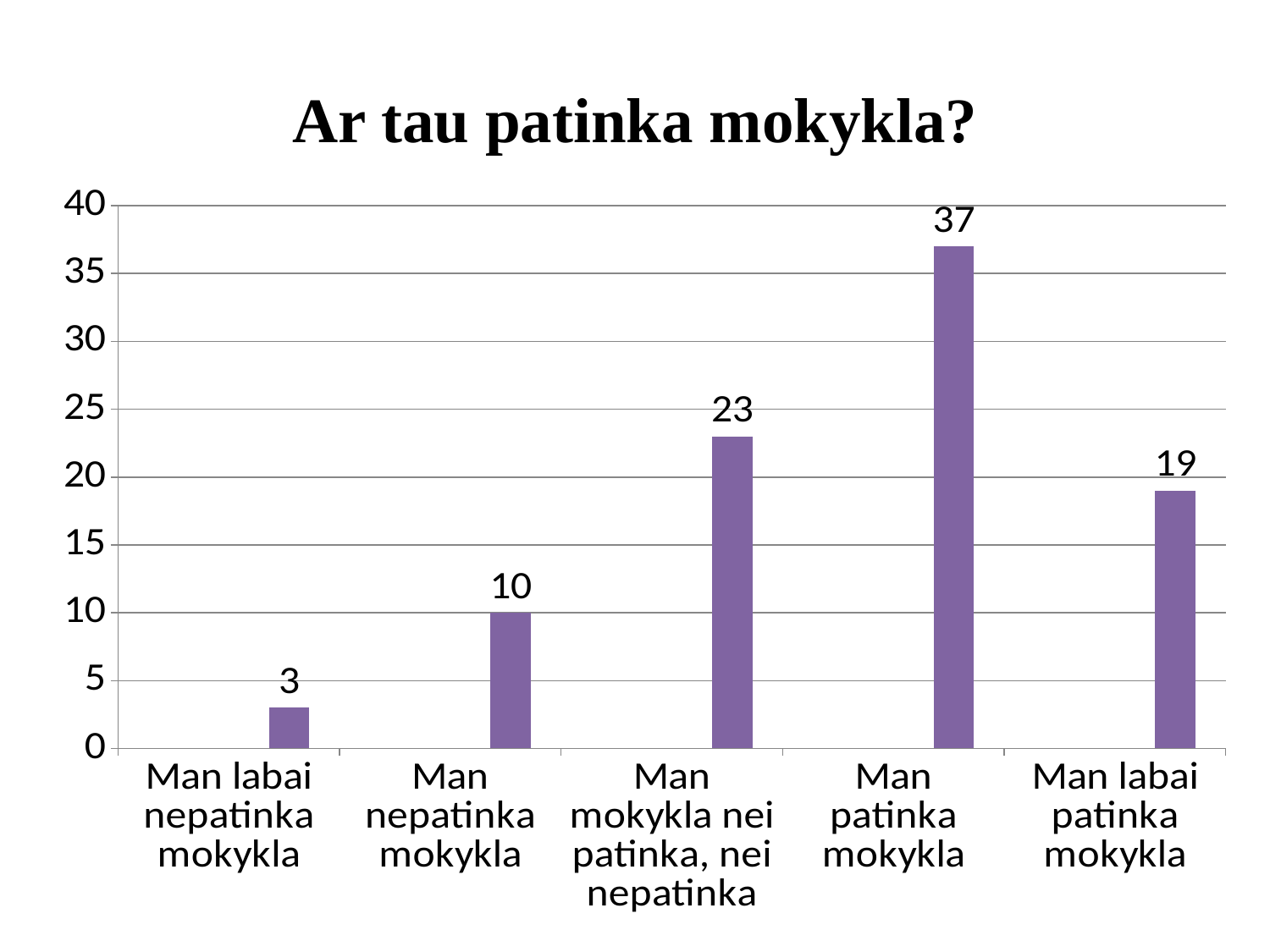
Which category has the lowest value? Man labai nepatinka mokykla Which category has the highest value? Man patinka mokykla Is the value for "Man mokykla nei patinka, nei nepatinka" greater or less than 20? greater What is the value for "Man labai nepatinka mokykla"? 3 What is the difference between the values for "Man patinka mokykla" and "Man labai patinka mokykla"? 18 What kind of chart is shown on the slide? bar chart What is the value for "Man mokykla nei patinka, nei nepatinka"? 23 How many categories are shown on the chart? 5 What is the value for "Man patinka mokykla"? 37 Which is larger, the value for "Man nepatinka mokykla" or the value for "Man labai patinka mokykla"? Man labai patinka mokykla What is the difference between the values for "Man nepatinka mokykla" and "Man labai nepatinka mokykla"? 7 What is the title of the chart? Ar tau patinka mokykla?